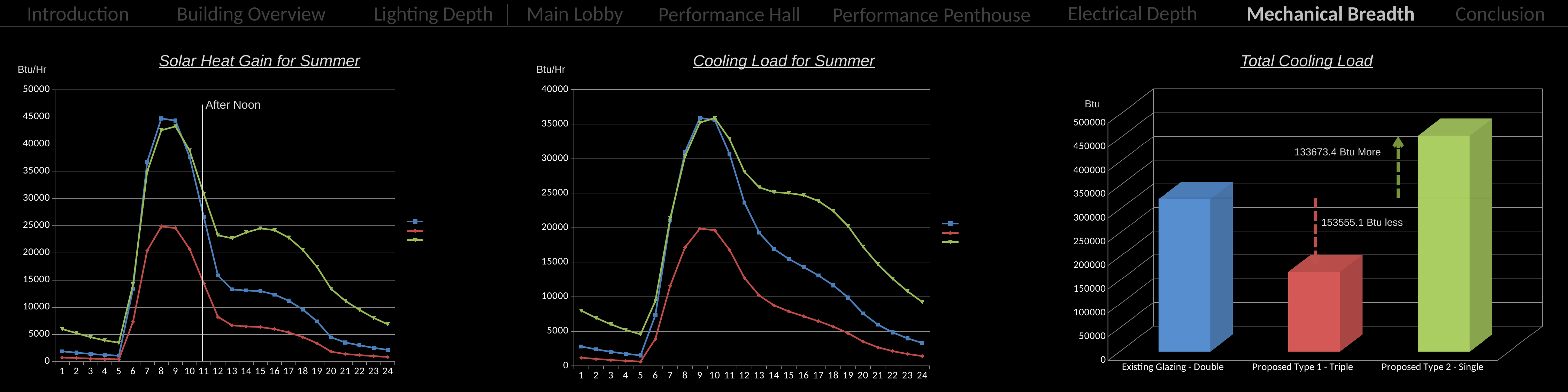
In the 'Total Cooling Load' chart, how many categories are shown? 3 In the 'Total Cooling Load' chart, which category has the lowest value? Proposed Type 1 - Triple In the 'Total Cooling Load' chart, which category has the highest value? Proposed Type 2 - Single In the 'Solar Heat Gain for Summer' chart, do the values of the blue series rise or fall from hour 12 to hour 24? fall In the 'Total Cooling Load' chart, is the value for Existing Glazing - Double greater or less than 300000? greater What kind of chart is the 'Total Cooling Load' chart? bar chart In the 'Total Cooling Load' chart, what does the annotation next to the green arrow say? 133673.4 Btu More In the 'Total Cooling Load' chart, which is larger: Existing Glazing - Double or Proposed Type 1 - Triple? Existing Glazing - Double In the 'Total Cooling Load' chart, is the value for Proposed Type 1 - Triple greater or less than 200000? less How many series does the legend of the 'Cooling Load for Summer' chart list? 3 In the 'Cooling Load for Summer' chart, how many hourly points are plotted along the x axis for each series? 24 What kind of chart is the 'Solar Heat Gain for Summer' chart? line chart